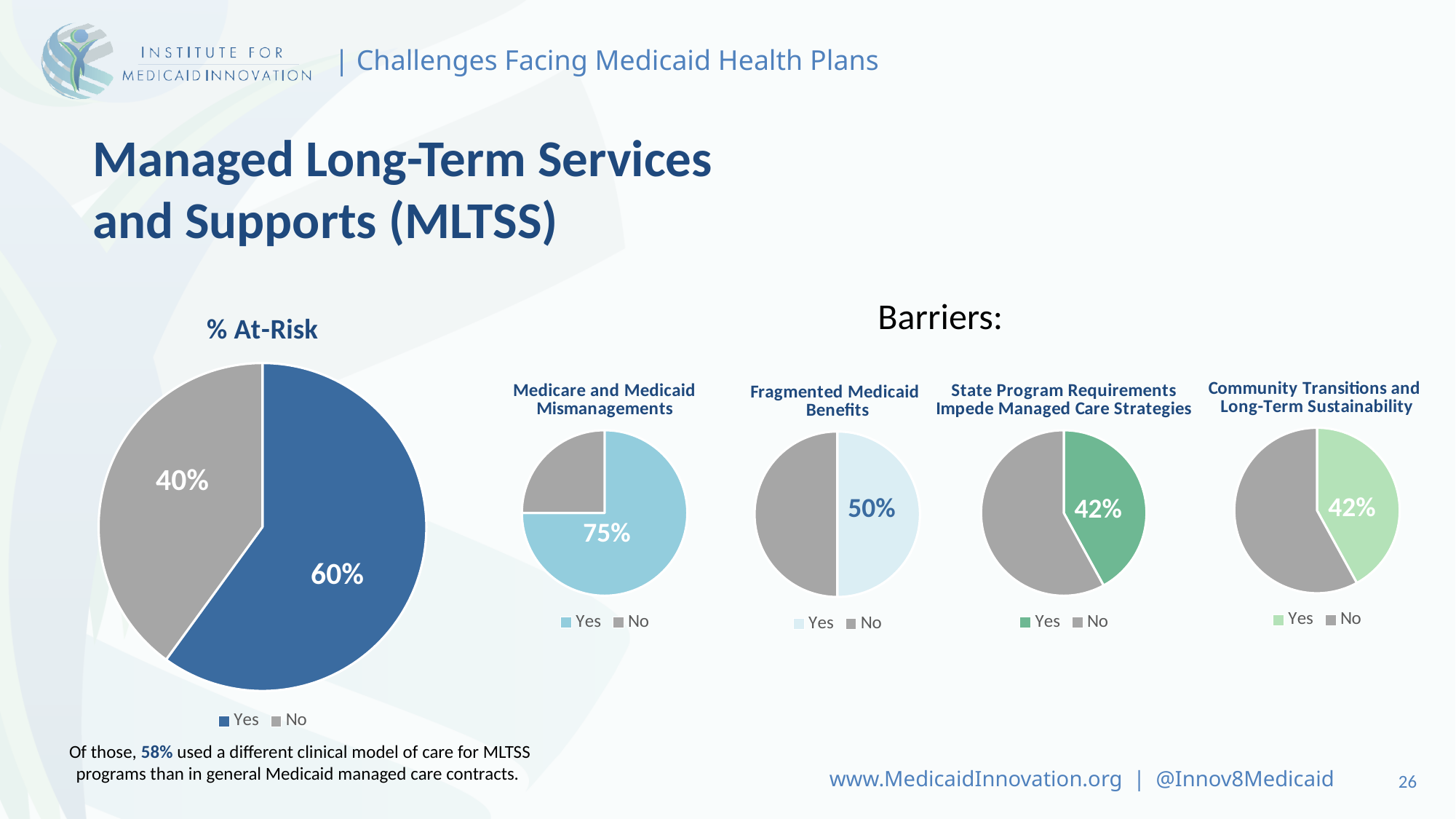
In the "% At-Risk" pie chart, what is the difference between the Yes and No slices? 20% How many pie charts are shown under the "Barriers:" heading? 4 In the "% At-Risk" pie chart, what percentage is shown for Yes? 60% In the "% At-Risk" pie chart, what percentage is shown for No? 40% How many entries does the legend of the "% At-Risk" pie chart list? 2 In the "State Program Requirements Impede Managed Care Strategies" pie chart, what percentage is labelled on the Yes slice? 42% Among the four barrier pie charts, which barrier has the largest Yes share? Medicare and Medicaid Mismanagements In the "Medicare and Medicaid Mismanagements" pie chart, what percentage is labelled on the Yes slice? 75% In the "% At-Risk" pie chart, which slice is larger, Yes or No? Yes What kind of chart is the "% At-Risk" chart? Pie chart In the "Fragmented Medicaid Benefits" pie chart, what percentage is labelled on the Yes slice? 50% In the "Community Transitions and Long-Term Sustainability" pie chart, what percentage is labelled on the Yes slice? 42%